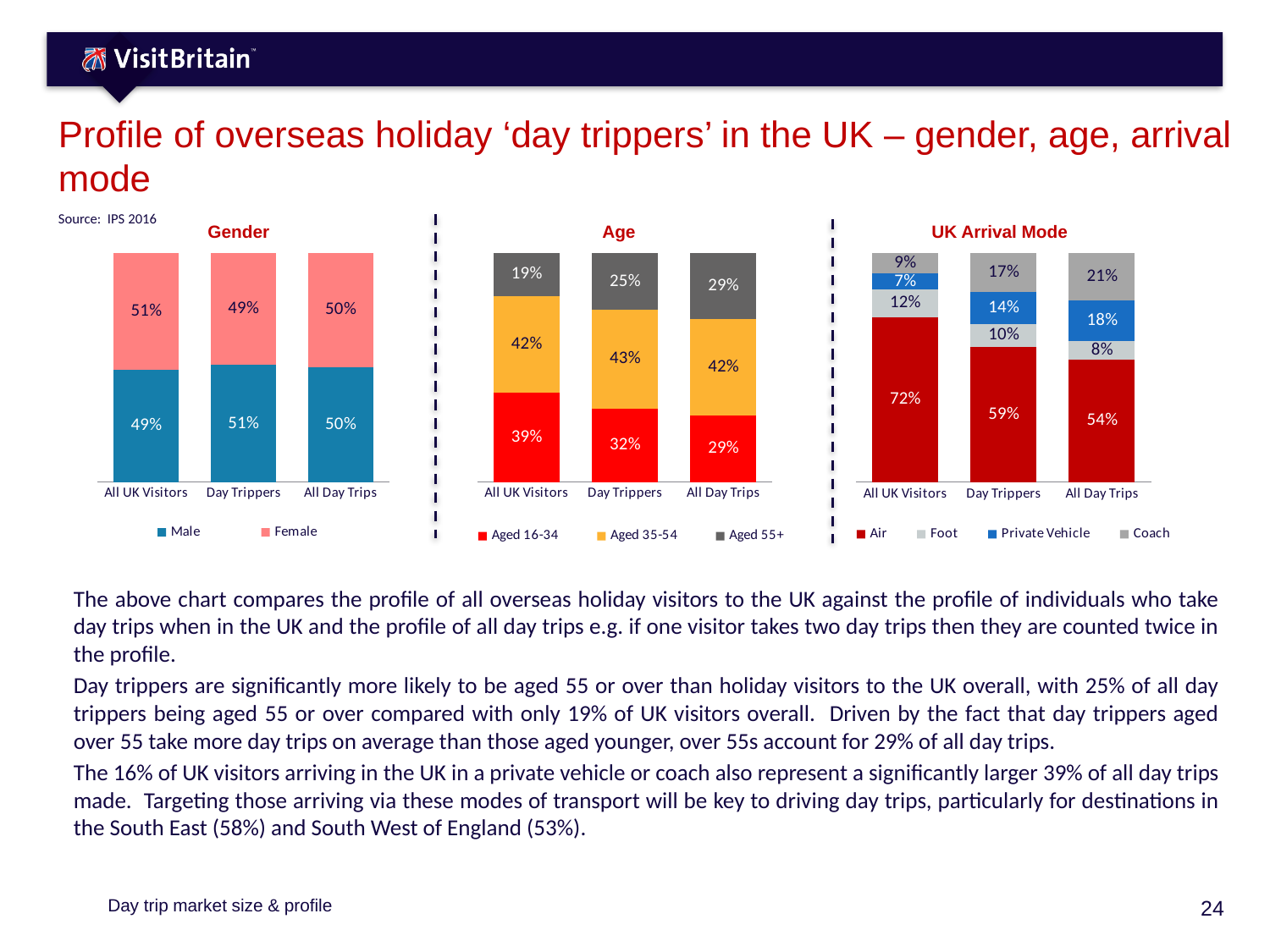
In the Age chart, which category has the highest share of Aged 16-34? All UK Visitors How many categories are shown on the x axis of the Age chart? 3 In the UK Arrival Mode chart, is the Coach share larger for Day Trippers or for All UK Visitors? Day Trippers In the Gender chart, what percentage of All UK Visitors are Female? 51% In the UK Arrival Mode chart, which category has the lowest Air share? All Day Trips In the Age chart, what percentage of Day Trippers are Aged 55+? 25% In the UK Arrival Mode chart, what percentage of All Day Trips arrived by Air? 54% In the UK Arrival Mode chart, what is the difference between the Private Vehicle share for All Day Trips and for All UK Visitors? 11% How many series does the legend of the UK Arrival Mode chart list? 4 What type of chart is the Gender chart? Stacked bar chart In the Age chart, what is the difference in the Aged 55+ share between All Day Trips and All UK Visitors? 10% In the Gender chart, what percentage of Day Trippers are Male? 51%